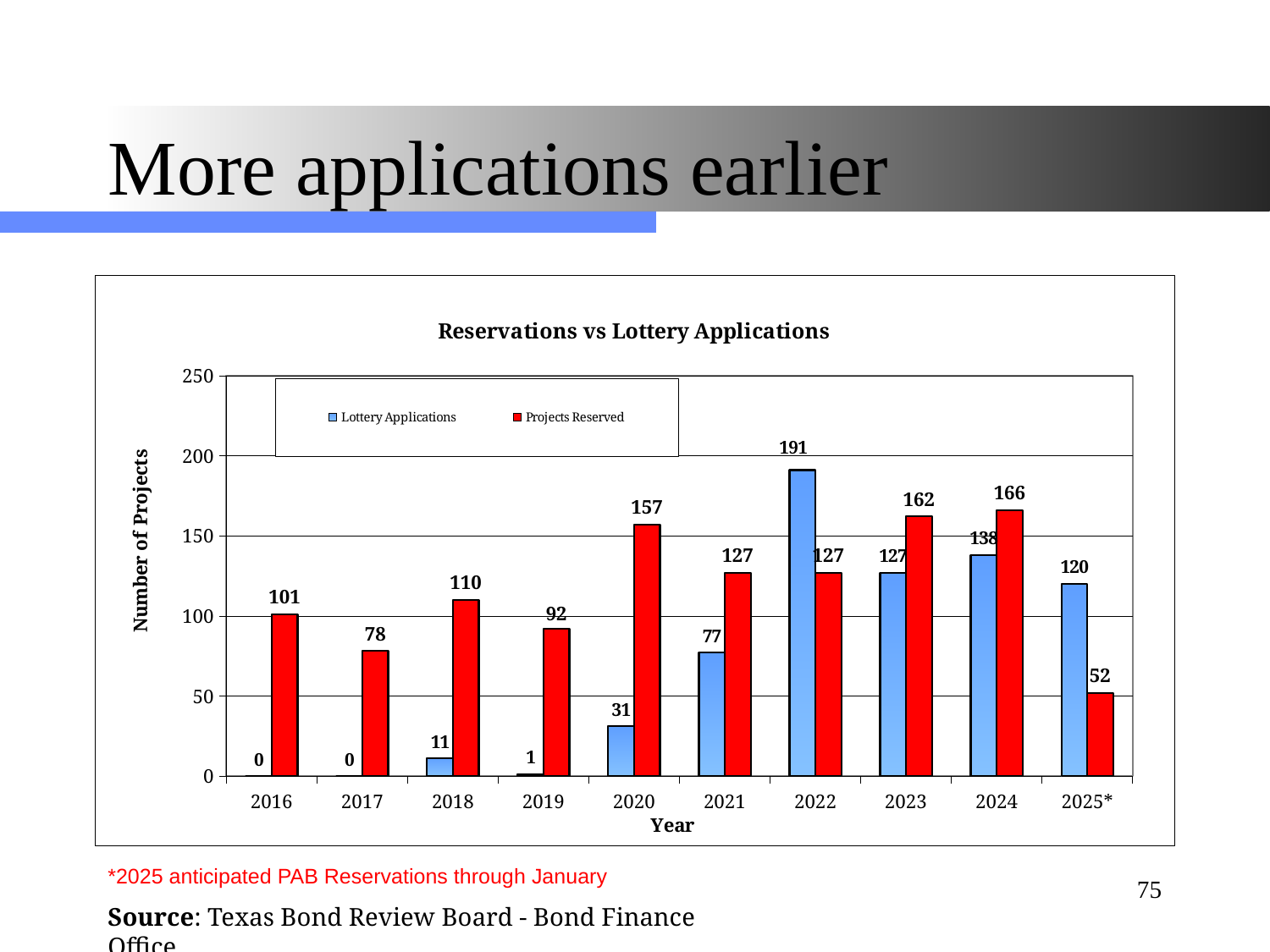
In 2021, which is larger: Lottery Applications or Projects Reserved? Projects Reserved How many series does the legend list? 2 How many years are shown on the x axis? 10 What is the value for Lottery Applications in 2022? 191 Which year has the highest value for Lottery Applications? 2022 What kind of chart is shown on the slide? bar chart What is the difference between Projects Reserved and Lottery Applications in 2024? 28 What is the title of the chart? Reservations vs Lottery Applications What is the value for Projects Reserved in 2025*? 52 Is the value for Projects Reserved in 2023 greater or less than 150? greater What is the value for Projects Reserved in 2020? 157 Which year has the lowest value for Projects Reserved? 2025*